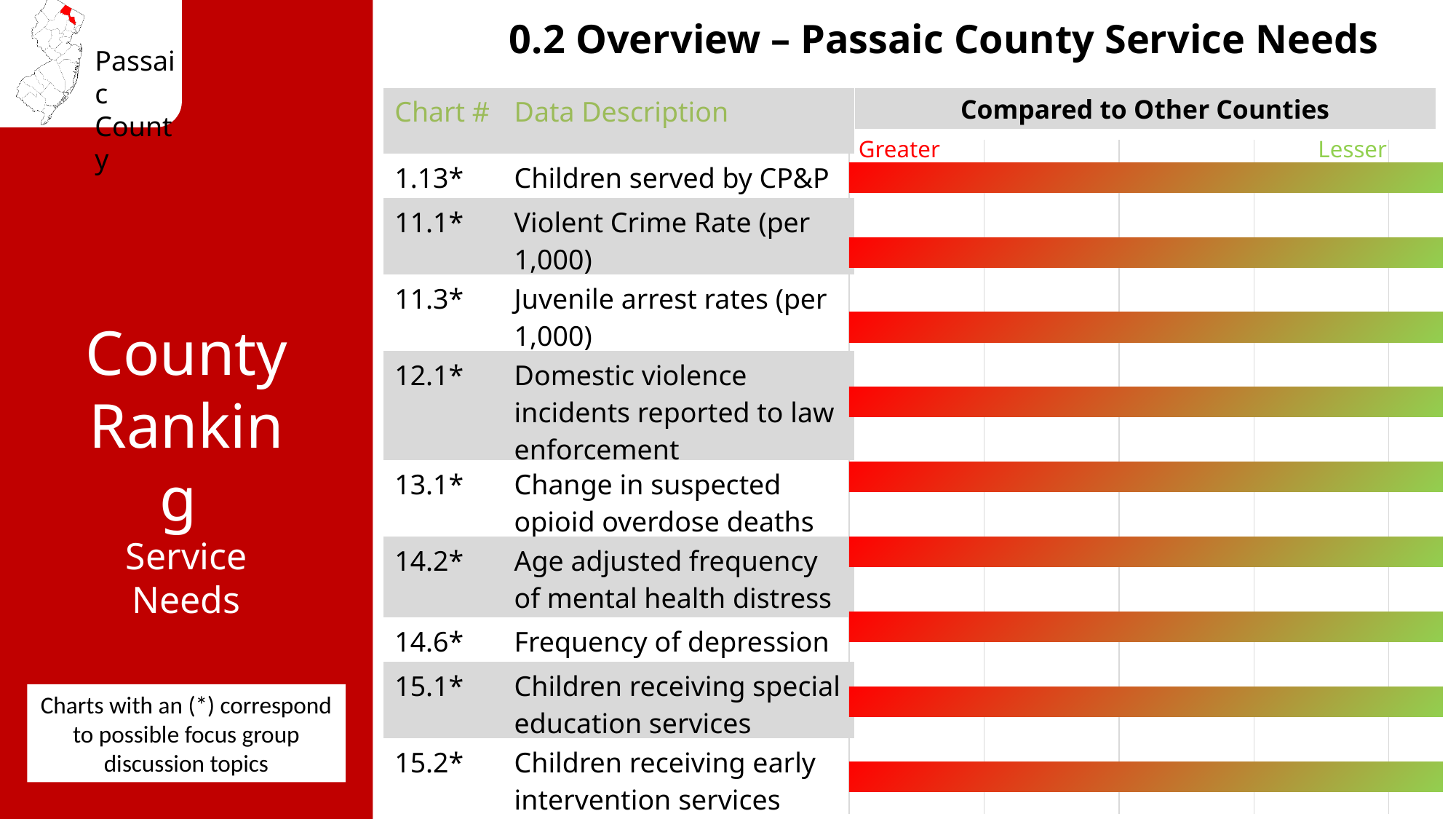
What are the two end labels of the 'Compared to Other Counties' scale? Greater and Lesser Which chart number corresponds to 'Violent Crime Rate (per 1,000)'? 11.1* What data description is listed for chart 13.1*? Change in suspected opioid overdose deaths What is the heading of the column containing the gradient bars? Compared to Other Counties Which chart number corresponds to 'Frequency of depression'? 14.6* How many data descriptions are listed in the County Ranking table on the slide? 9 What data description is listed for chart 15.2*? Children receiving early intervention services Which chart number corresponds to 'Children served by CP&P'? 1.13*